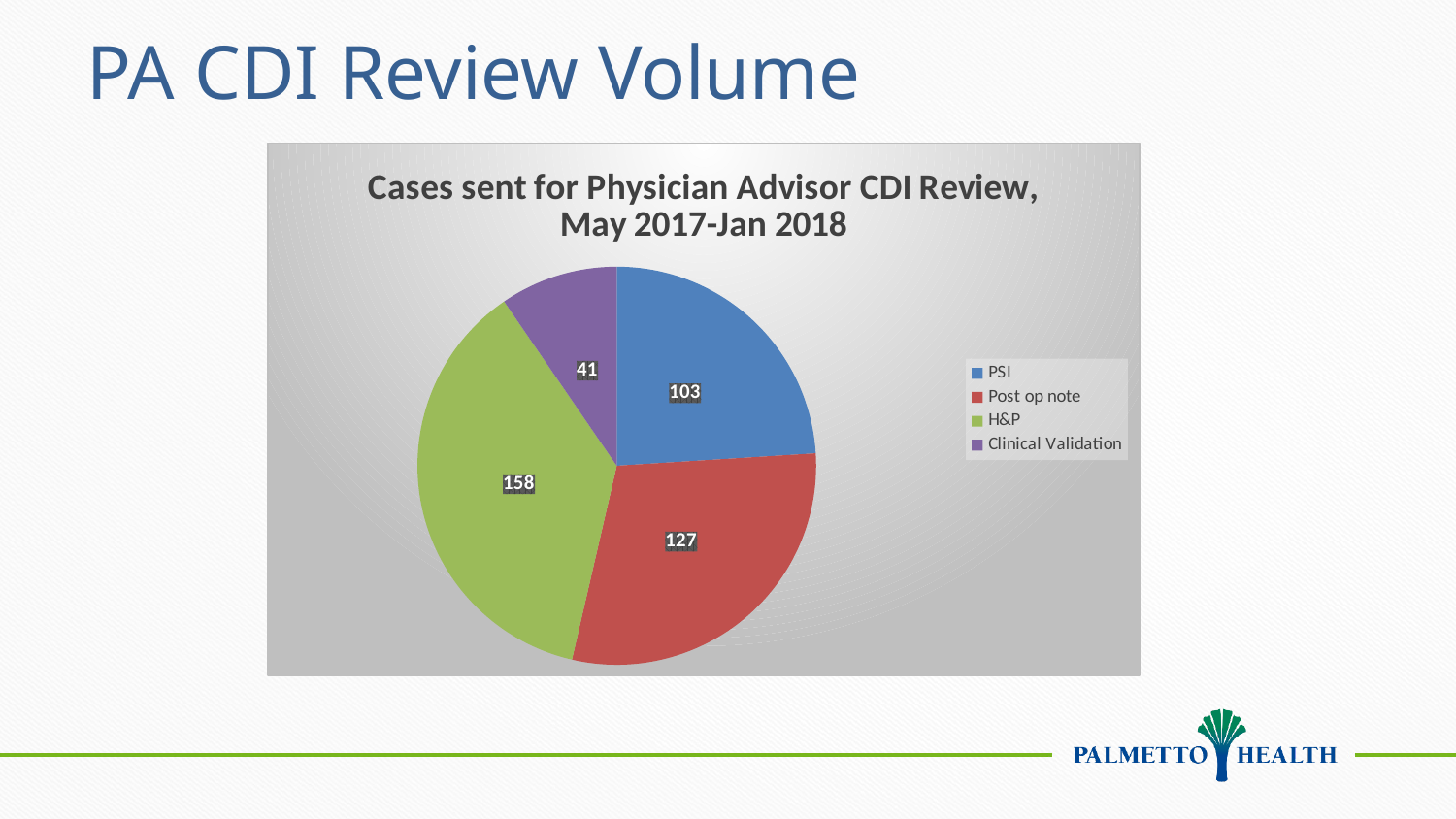
What is the title of the chart? Cases sent for Physician Advisor CDI Review, May 2017-Jan 2018 What is the total number of cases across all four categories? 429 Which is larger, Post op note or PSI? Post op note How many cases were sent for Clinical Validation? 41 How many cases were sent for Post op note? 127 Which category has the smallest slice of the pie? Clinical Validation What type of chart is shown on the slide? Pie chart Which category has the largest slice of the pie? H&P How many cases were sent for PSI? 103 How many cases were sent for H&P? 158 What is the difference between the H&P and PSI values? 55 How many categories does the pie chart show? 4